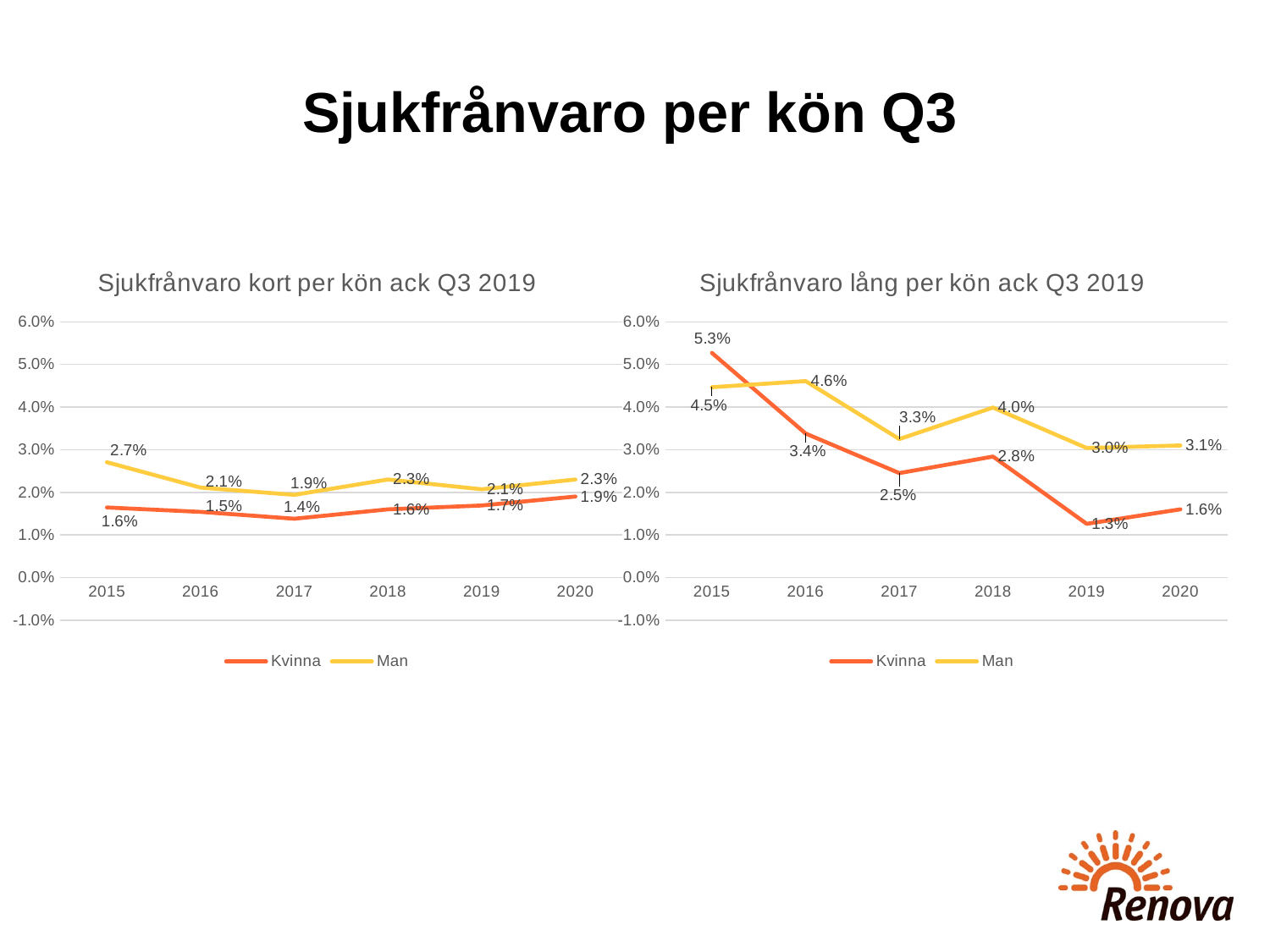
What kind of chart is the chart titled "Sjukfrånvaro lång per kön ack Q3 2019"? line chart In the chart titled "Sjukfrånvaro lång per kön ack Q3 2019", what is the difference between the Kvinna values in 2015 and 2020? 3.7% In the chart titled "Sjukfrånvaro kort per kön ack Q3 2019", in which year is the Kvinna value lowest? 2017 In the chart titled "Sjukfrånvaro kort per kön ack Q3 2019", what is the difference between Man and Kvinna in 2020? 0.4% In the chart titled "Sjukfrånvaro kort per kön ack Q3 2019", what is the value for Man in 2015? 2.7% In the chart titled "Sjukfrånvaro lång per kön ack Q3 2019", does the Kvinna line generally rise or fall from 2015 to 2020? fall In the chart titled "Sjukfrånvaro lång per kön ack Q3 2019", what is the value for Man in 2018? 4.0% In the chart titled "Sjukfrånvaro kort per kön ack Q3 2019", what is the value for Kvinna in 2017? 1.4% In the chart titled "Sjukfrånvaro lång per kön ack Q3 2019", which is larger in 2019, Kvinna or Man? Man In the chart titled "Sjukfrånvaro lång per kön ack Q3 2019", what is the value for Kvinna in 2015? 5.3% In the chart titled "Sjukfrånvaro lång per kön ack Q3 2019", in which year is the Man value highest? 2016 In the chart titled "Sjukfrånvaro kort per kön ack Q3 2019", how many years are shown on the x axis? 6